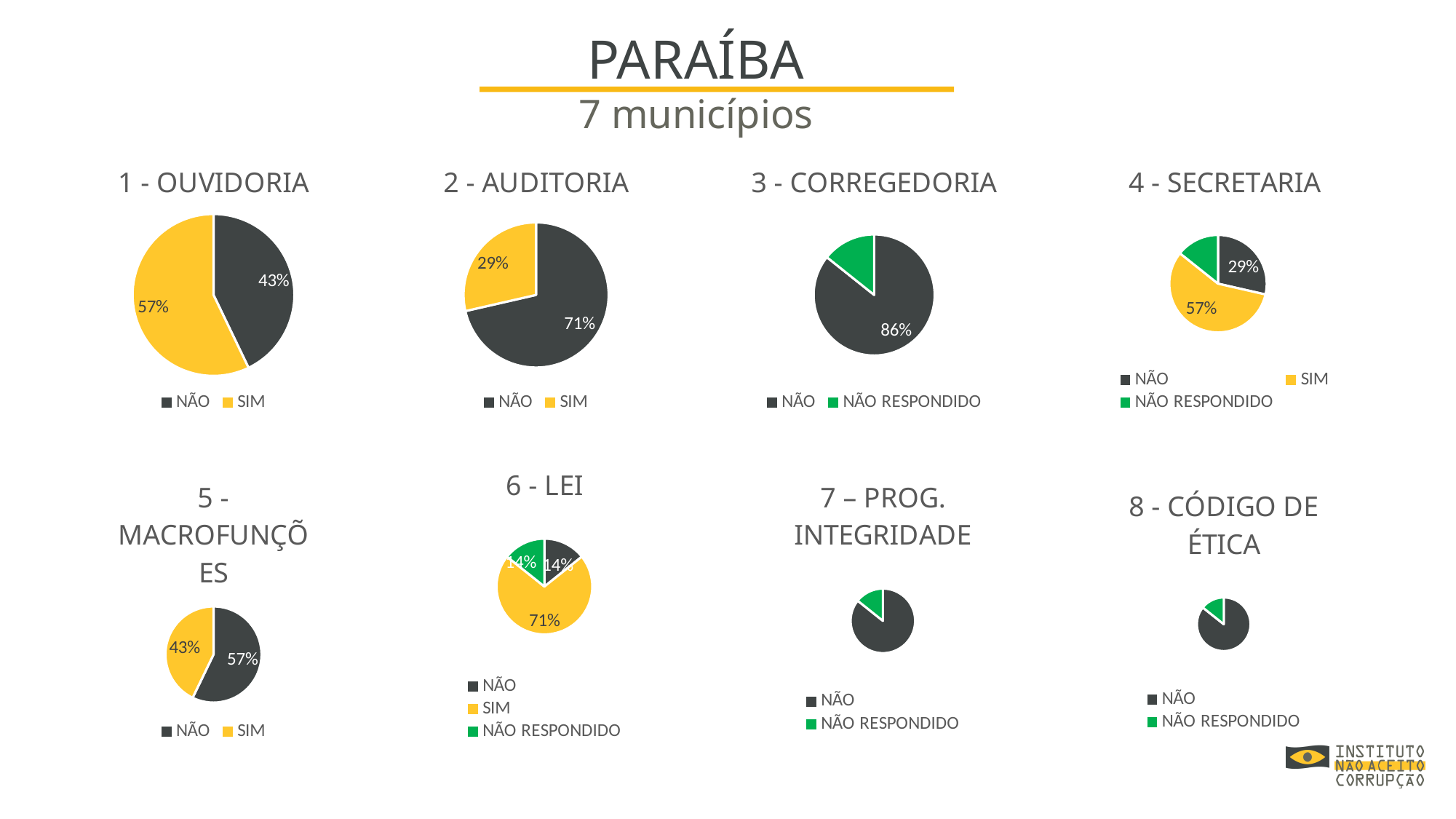
In the "1 - OUVIDORIA" pie chart, what share is labelled for SIM? 57% In the "5 - MACROFUNÇÕES" pie chart, what percentage is shown for NÃO? 57% In the "6 - LEI" pie chart, what percentage is shown for SIM? 71% In the "4 - SECRETARIA" pie chart, what percentage is shown for SIM? 57% In the "2 - AUDITORIA" pie chart, what percentage is shown for NÃO? 71% In the "1 - OUVIDORIA" pie chart, what percentage is shown for NÃO? 43% What type of chart is used for "7 – PROG. INTEGRIDADE"? Pie chart In the "2 - AUDITORIA" pie chart, which slice is larger, NÃO or SIM? NÃO In the "4 - SECRETARIA" pie chart, which category has the largest slice? SIM In the "3 - CORREGEDORIA" pie chart, what percentage is shown for NÃO? 86% How many pie charts are shown on the slide? 8 How many categories does the legend of the "6 - LEI" chart list? 3